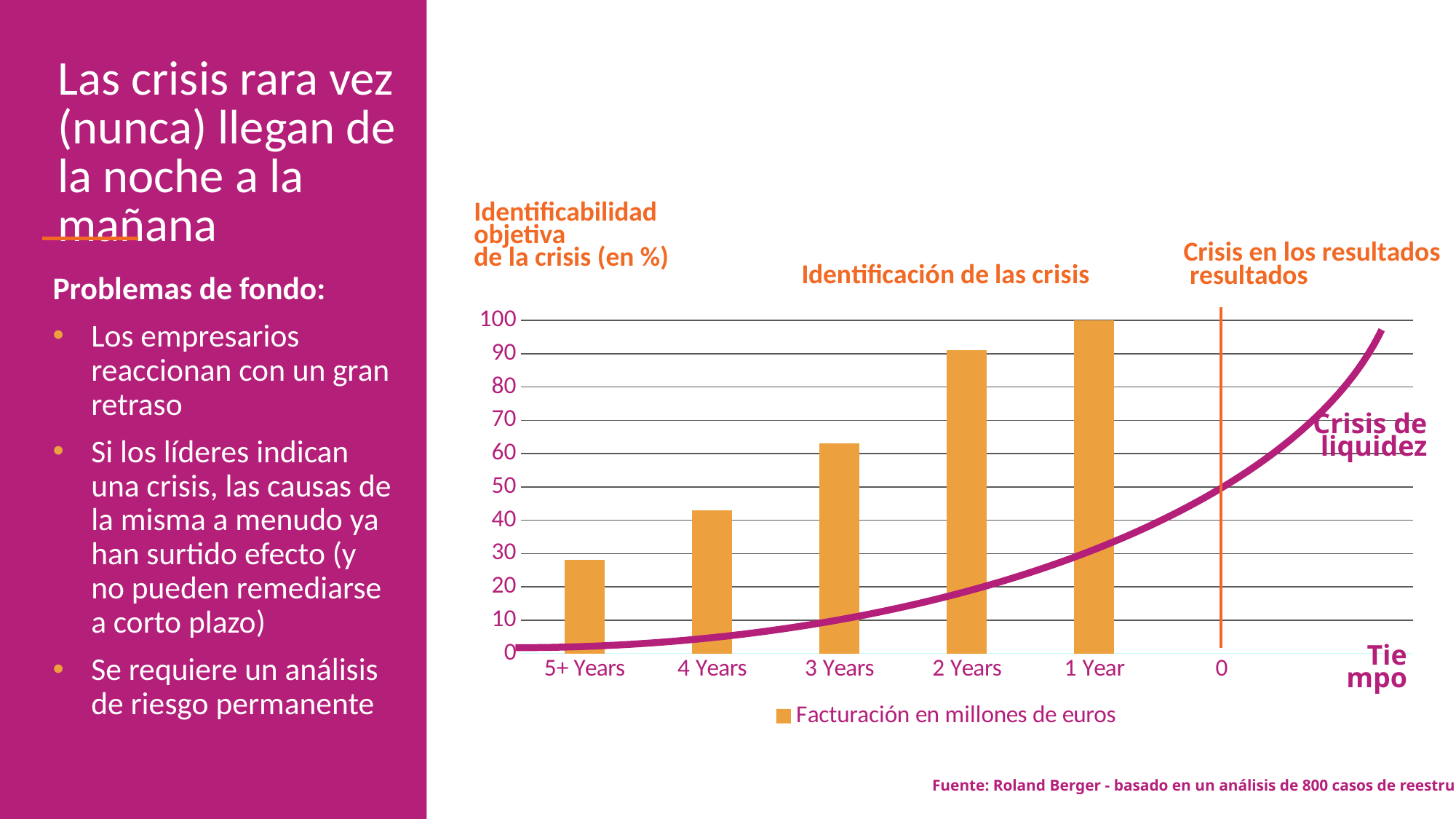
Which is larger, the value for 2 Years or the value for 4 Years? 2 Years Which category has the lowest bar? 5+ Years How many bars are plotted in the chart? 5 Is the value for 5+ Years greater or less than 40? less Is the value for 2 Years greater or less than 80? greater Is the value for 4 Years greater or less than 50? less How many series does the legend list? 1 What kind of chart is shown on the slide? bar chart Do the bar values rise or fall from 5+ Years to 1 Year? rise What is the value for 1 Year? 100 Which category has the highest bar? 1 Year